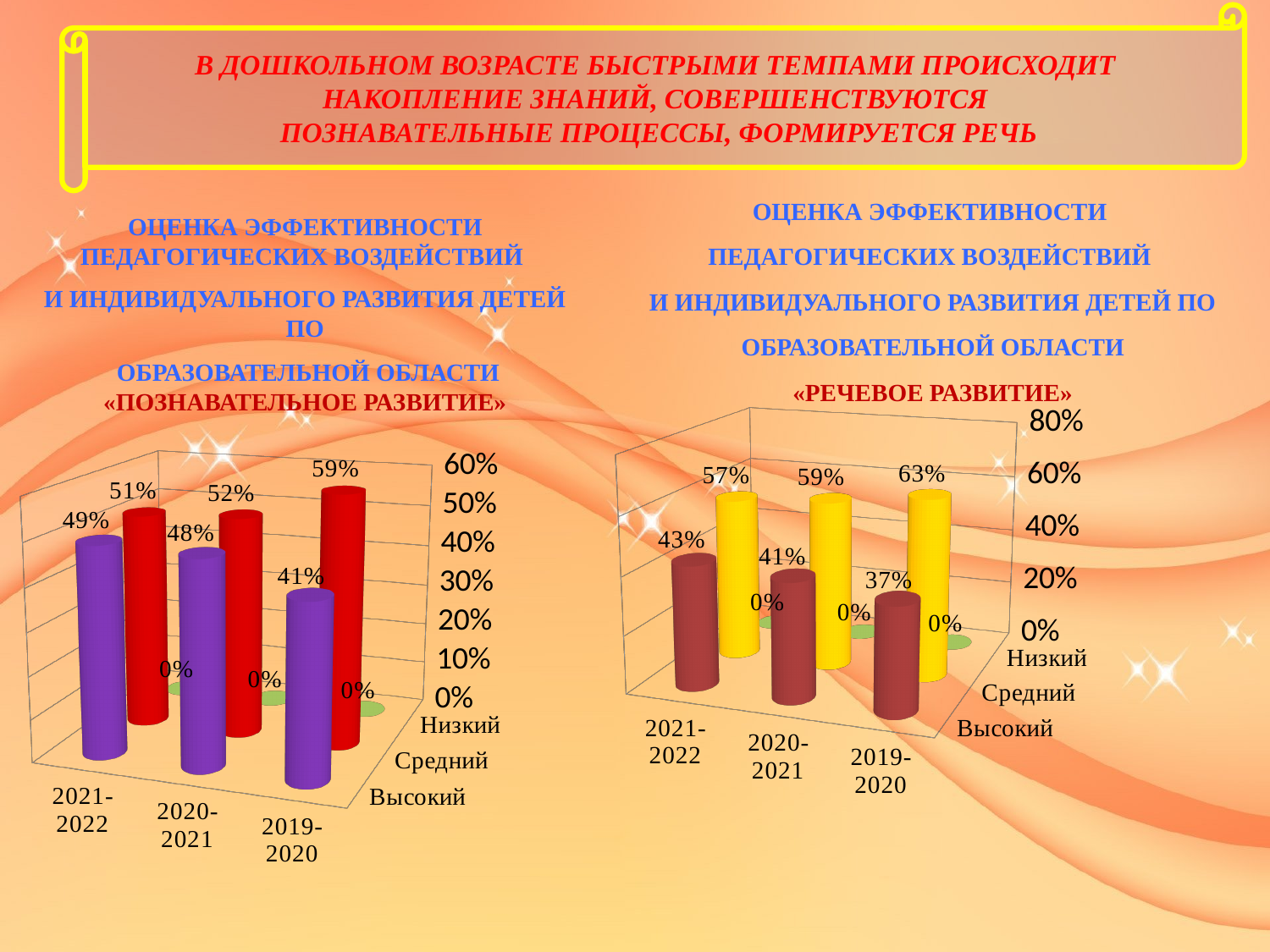
On the «Познавательное развитие» chart, which year has the lowest value for Высокий? 2019-2020 On the «Речевое развитие» chart, do the Высокий values rise or fall from 2021-2022 to 2019-2020? Fall On the «Речевое развитие» chart, which is larger in 2021-2022: Высокий or Средний? Средний On the «Познавательное развитие» chart, what is the value for Средний in 2019-2020? 59% On the «Речевое развитие» chart, what is the value for Низкий in 2019-2020? 0% On the «Познавательное развитие» chart, what is the difference between the Средний and Высокий values in 2019-2020? 18% What type of chart is the «Речевое развитие» chart? Bar chart On the «Речевое развитие» chart, what is the value for Высокий in 2020-2021? 41% How many year categories are shown on the «Познавательное развитие» chart? 3 On the «Речевое развитие» chart, what is the value for Средний in 2021-2022? 57% On the «Познавательное развитие» chart, what is the value for Высокий in 2021-2022? 49% On the «Речевое развитие» chart, which year has the highest value for Средний? 2019-2020